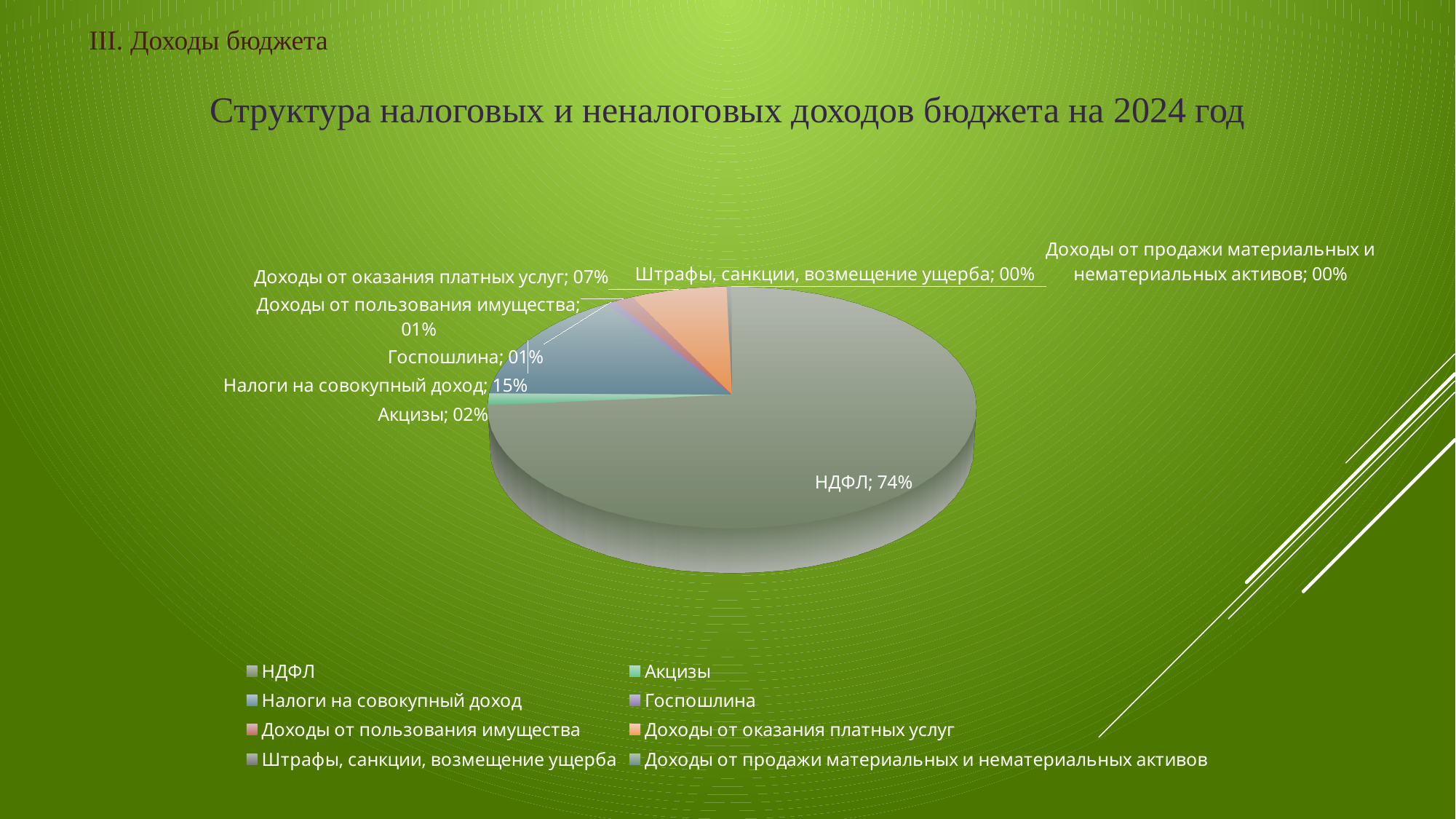
Which category has the largest share of the pie? НДФЛ What share of the pie does НДФЛ account for? 74% What is the difference in percentage points between НДФЛ and Налоги на совокупный доход? 59 What is the value shown for Налоги на совокупный доход? 15% What is the value shown for Доходы от оказания платных услуг? 07% What is the value shown for Госпошлина? 01% Which is larger, the share for Доходы от оказания платных услуг or the share for Акцизы? Доходы от оказания платных услуг What is the value shown for Акцизы? 02% What value is shown for Штрафы, санкции, возмещение ущерба? 00% How many categories does the legend list? 8 What is the title of the chart? Структура налоговых и неналоговых доходов бюджета на 2024 год What kind of chart is shown on the slide? Pie chart